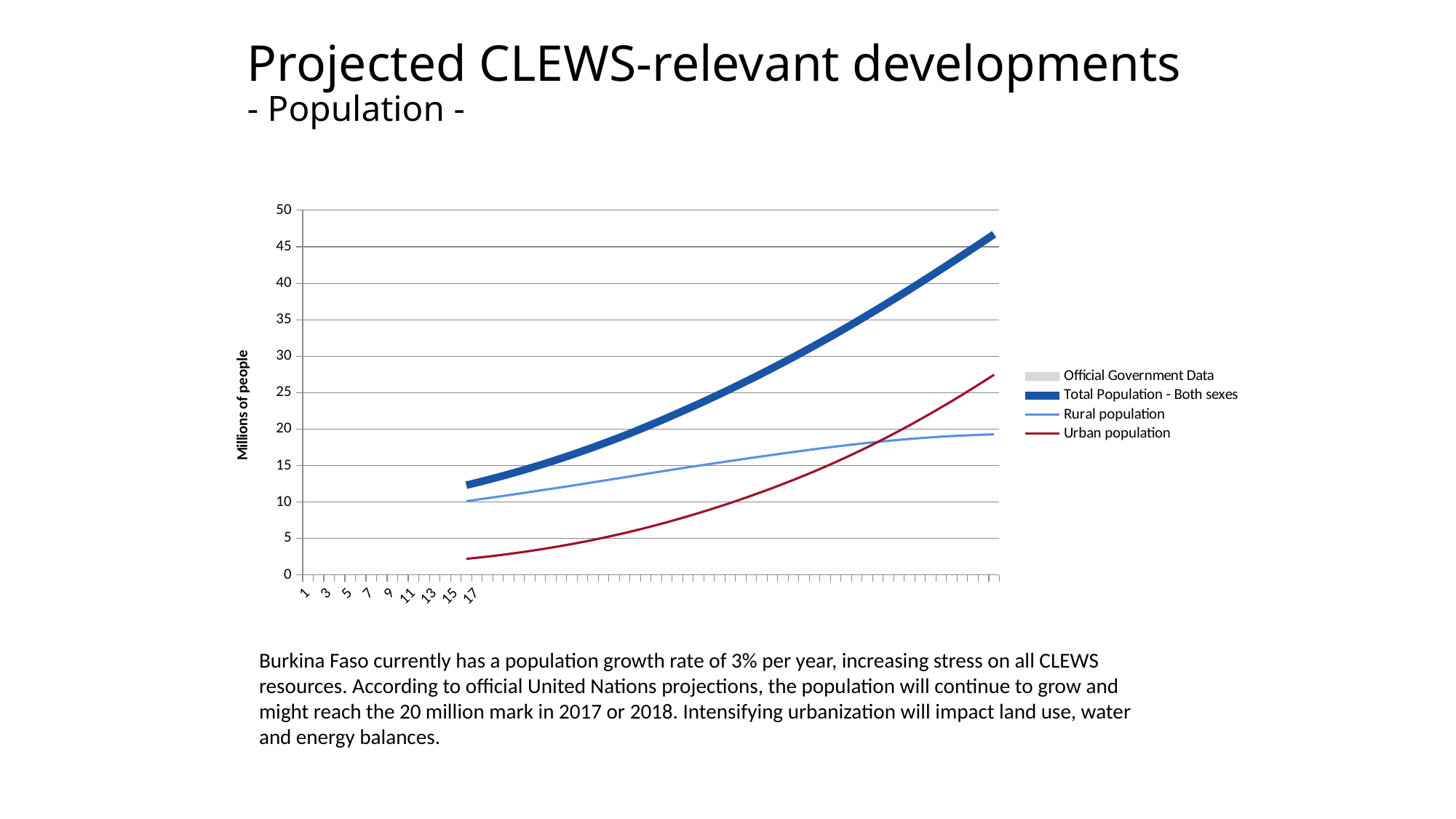
Does the Total Population - Both sexes line rise or fall from left to right? rise At the right end of the chart, is the value for Total Population - Both sexes greater or less than 40? greater At the right end of the chart, which is larger: Urban population or Rural population? Urban population Does the Urban population line rise or fall from left to right? rise At the right end of the chart, is the value for Urban population greater or less than 25? greater At the right end of the chart, is the value for Rural population greater or less than 20? less Which series is drawn in red on the chart? Urban population What kind of chart is shown on the slide? line chart What is the title of the vertical axis of the chart? Millions of people How many series does the chart's legend list? 4 Which series reaches the highest value on the chart? Total Population - Both sexes